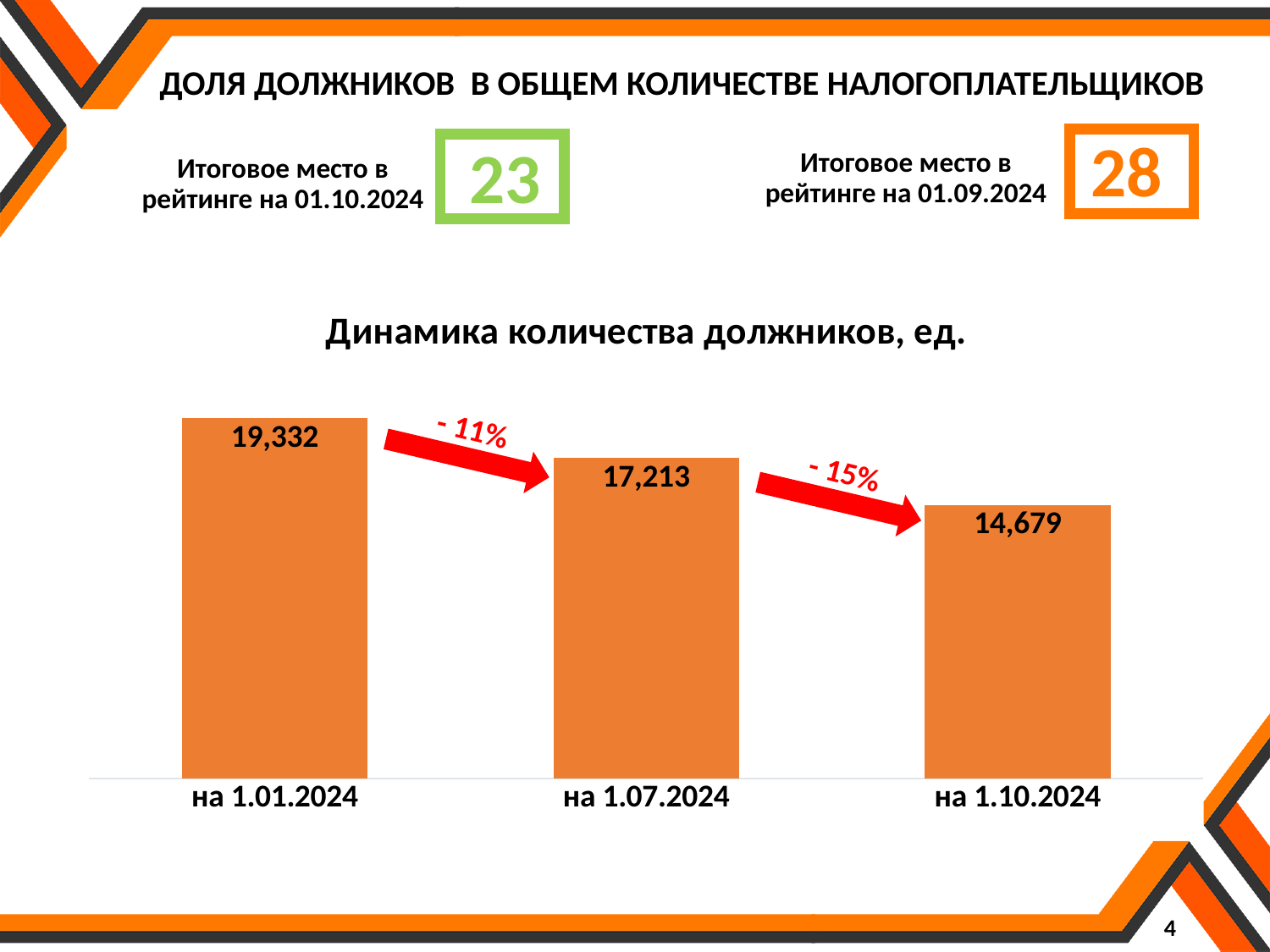
Which is larger: the number of debtors on 1.07.2024 or on 1.10.2024? на 1.07.2024 Do the values rise or fall from 1.01.2024 to 1.10.2024? Fall How many bars are shown in the chart? 3 What is the difference between the number of debtors on 1.01.2024 and on 1.10.2024? 4,653 What type of chart is used to show the dynamics of the number of debtors? Bar chart What is the difference between the number of debtors on 1.07.2024 and on 1.10.2024? 2,534 What is the difference between the number of debtors on 1.01.2024 and on 1.07.2024? 2,119 What is the number of debtors shown for на 1.10.2024? 14,679 What is the number of debtors shown for на 1.01.2024? 19,332 What is the number of debtors shown for на 1.07.2024? 17,213 Which date has the lowest number of debtors? на 1.10.2024 Which date has the highest number of debtors? на 1.01.2024